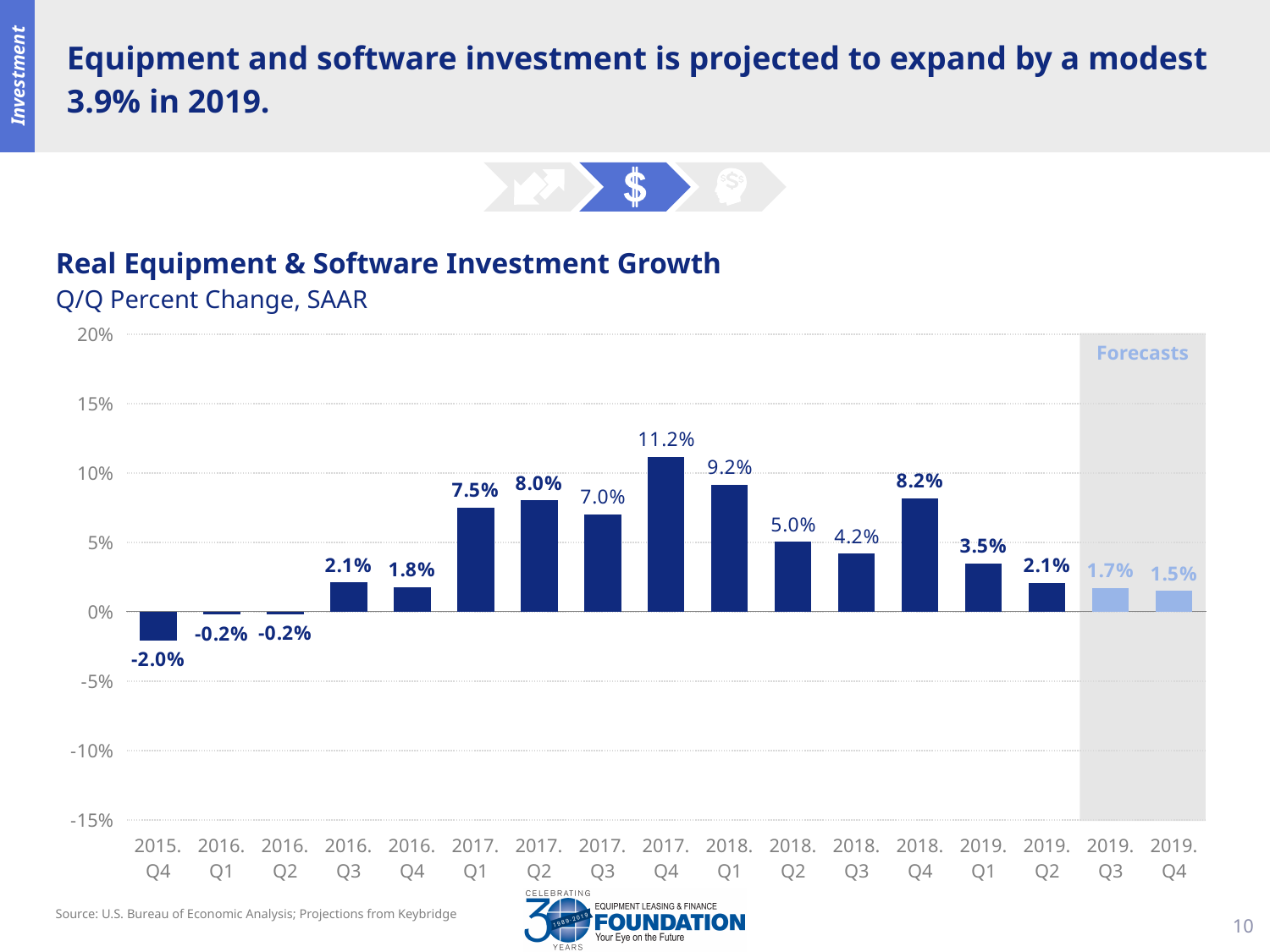
Which is larger, the value for 2018 Q4 or the value for 2018 Q2? 2018 Q4 How many quarters are shown on the x axis? 17 Which quarter has the highest value? 2017 Q4 What is the value for 2015 Q4? -2.0% Which quarter has the lowest value? 2015 Q4 What label is shown in the shaded area on the right of the chart? Forecasts Do the values rise or fall from 2018 Q4 to 2019 Q4? Fall Is the value for 2018 Q1 greater or less than 5%? greater What kind of chart is this? Bar chart What is the forecast value for 2019 Q4? 1.5% What is the value for 2017 Q4? 11.2% What is the difference between the values for 2017 Q4 and 2018 Q1? 2.0%